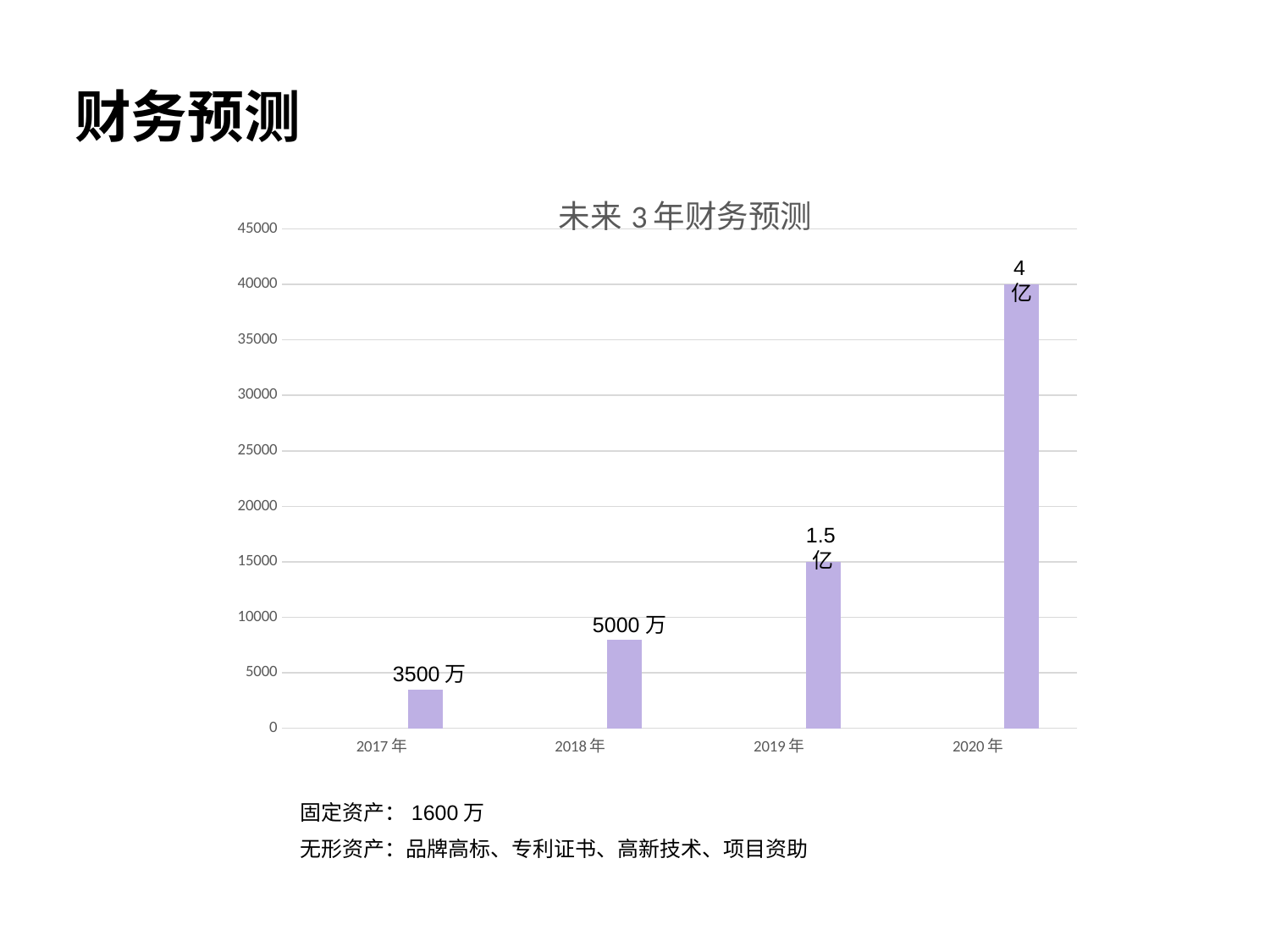
What is the value shown for 2017 年? 3500 万 Do the values rise or fall from 2017 年 to 2020 年? rise Which year has the lowest value? 2017 年 What is the value shown for 2020 年? 4 亿 What is the difference between the values for 2020 年 and 2019 年? 2.5 亿 What is the value shown for 2019 年? 1.5 亿 What is the value shown for 2018 年? 5000 万 Is the bar for 2017 年 greater or less than 5000 on the axis? less How many years are shown on the x axis? 4 Which is larger, the value for 2019 年 or the value for 2018 年? 2019 年 What is the difference between the values for 2018 年 and 2017 年? 1500 万 Which year has the highest value? 2020 年